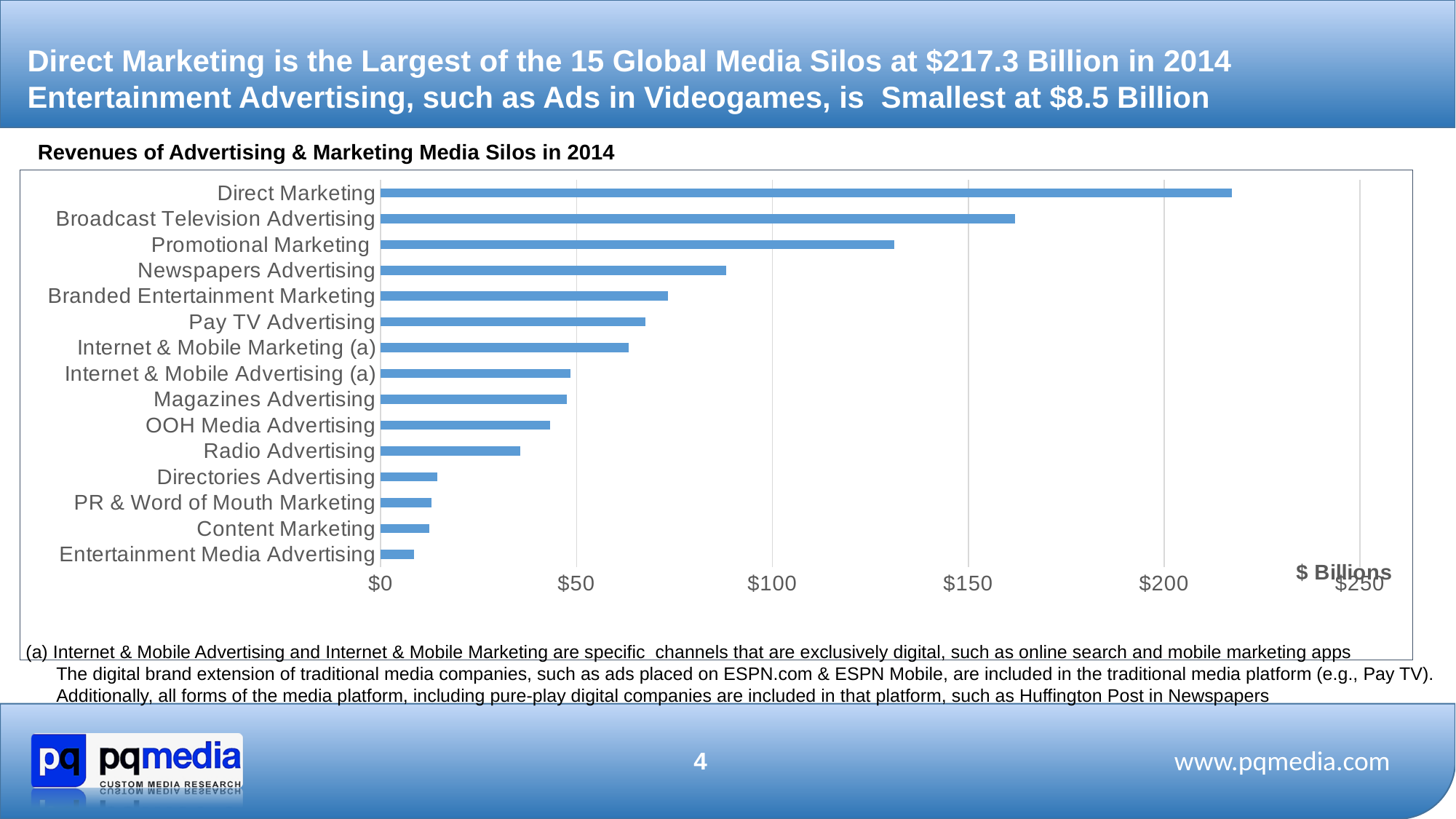
Which media silo has the lowest revenue in the chart? Entertainment Media Advertising Is the value for Newspapers Advertising greater or less than $100? less What kind of chart is shown on the slide? bar chart What is the title of the chart? Revenues of Advertising & Marketing Media Silos in 2014 Which is larger, Pay TV Advertising or Magazines Advertising? Pay TV Advertising Which media silo has the highest revenue in the chart? Direct Marketing How many media silos (categories) are plotted in the chart? 15 What is the difference between the revenue of Direct Marketing ($217.3 Billion) and Entertainment Media Advertising ($8.5 Billion)? $208.8 Billion What unit is indicated on the horizontal axis of the chart? $ Billions According to the slide, what is the 2014 revenue of Direct Marketing? $217.3 Billion Is the value for Broadcast Television Advertising greater or less than $150? greater According to the slide, what is the 2014 revenue of Entertainment Media Advertising? $8.5 Billion